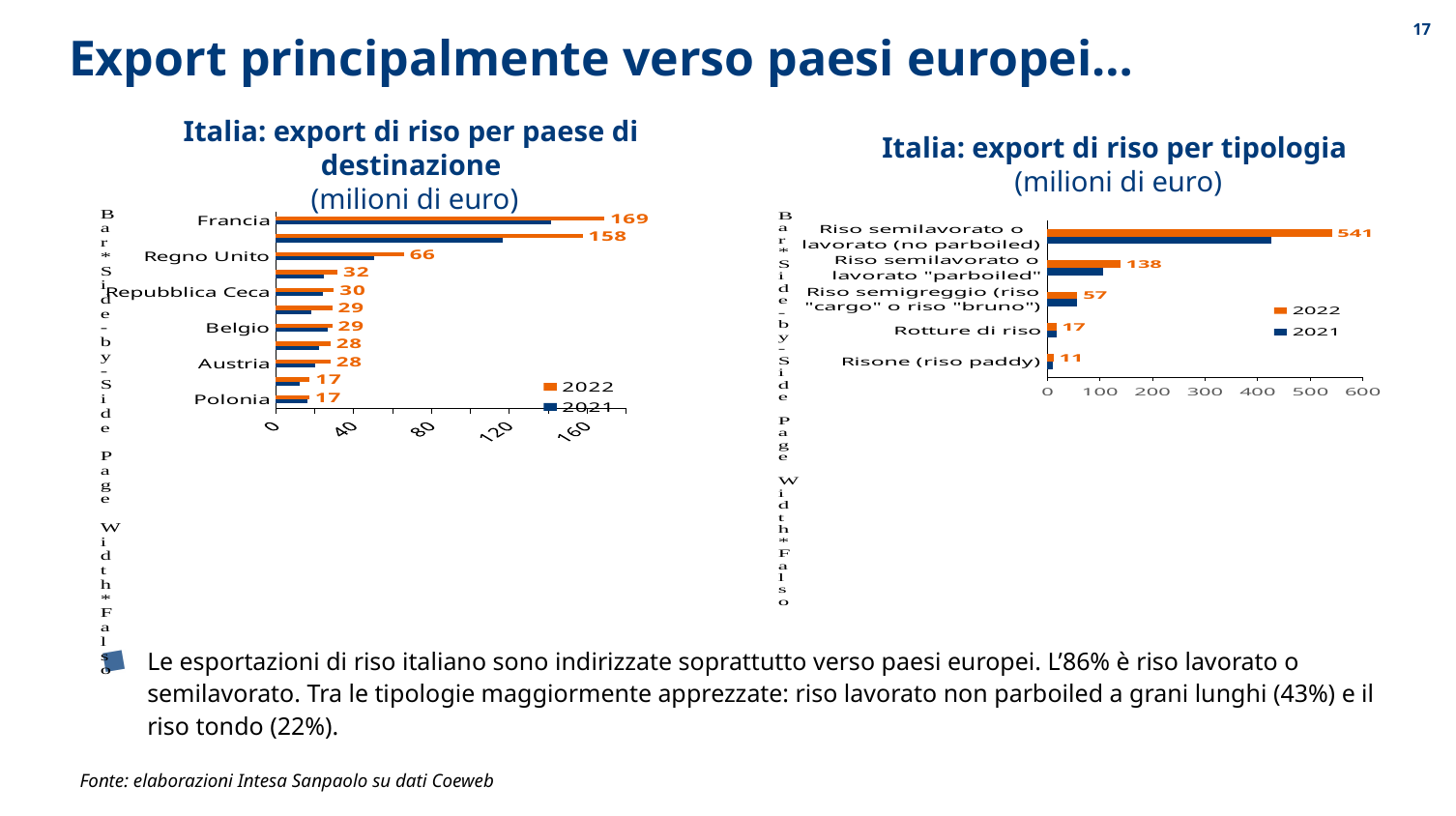
In the chart 'Italia: export di riso per tipologia', what is the 2022 value for 'Riso semilavorato o lavorato (no parboiled)'? 541 In the chart 'Italia: export di riso per tipologia', what is the difference between the 2022 values for 'Riso semilavorato o lavorato (no parboiled)' and 'Riso semilavorato o lavorato "parboiled"'? 403 In the chart 'Italia: export di riso per tipologia', what is the 2022 value for 'Rotture di riso'? 17 How many series does the legend list in the chart 'Italia: export di riso per paese di destinazione'? 2 In the chart 'Italia: export di riso per paese di destinazione', which has the larger 2022 value, Regno Unito or Repubblica Ceca? Regno Unito How many categories are shown in the chart 'Italia: export di riso per tipologia'? 5 In the chart 'Italia: export di riso per tipologia', which category has the lowest 2022 value? Risone (riso paddy) How many countries are shown in the chart 'Italia: export di riso per paese di destinazione'? 11 In the chart 'Italia: export di riso per paese di destinazione', what is the 2022 value for Francia? 169 In the chart 'Italia: export di riso per tipologia', which category has the highest 2022 value? Riso semilavorato o lavorato (no parboiled) In the chart 'Italia: export di riso per tipologia', is the 2021 value for 'Riso semilavorato o lavorato (no parboiled)' greater or less than 300? greater